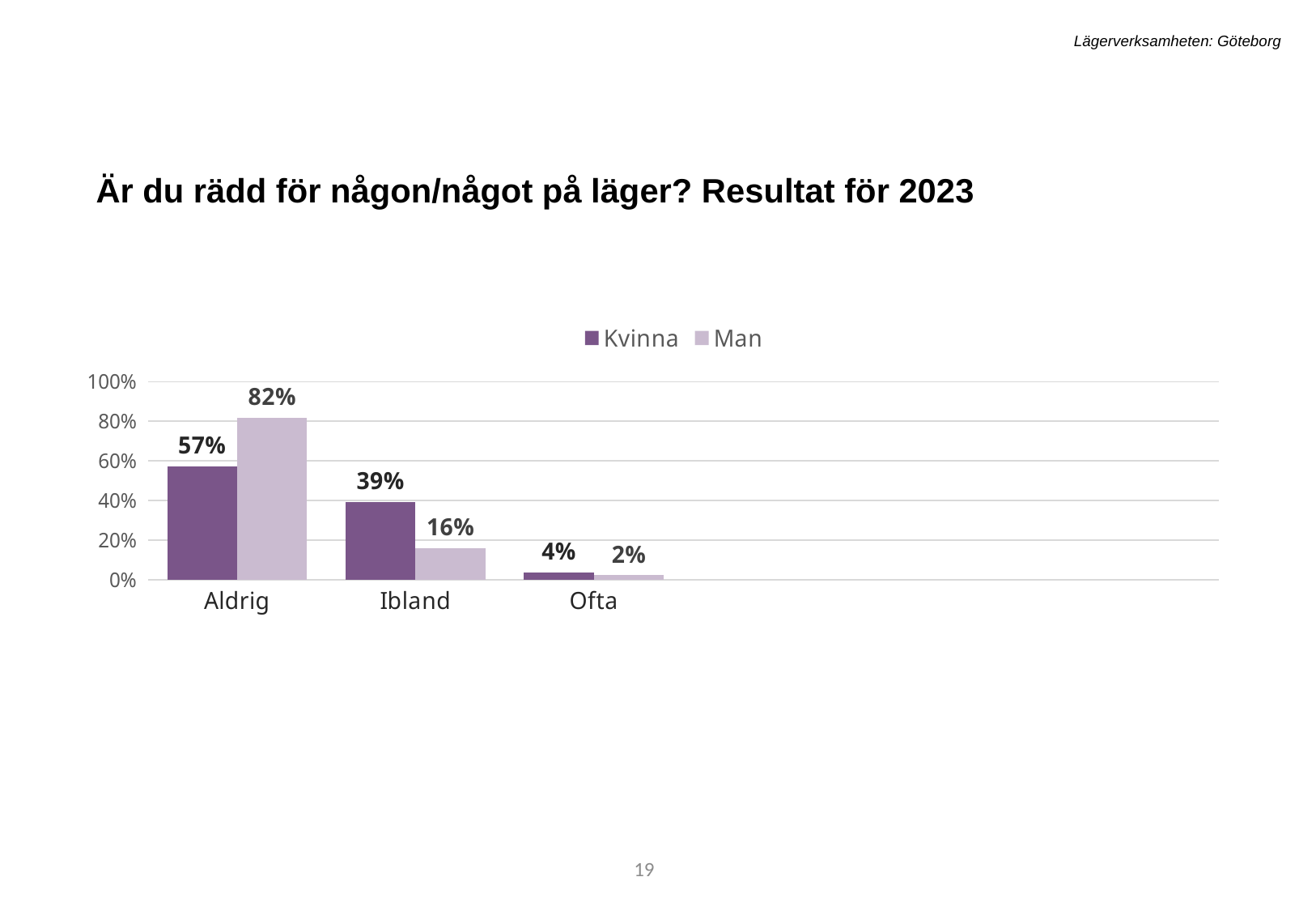
In the Ibland category, which series has the larger value, Kvinna or Man? Kvinna Which category has the lowest value for the Kvinna series? Ofta What is the difference between the Kvinna and Man values in the Ibland category? 23% What kind of chart is shown on the slide? Bar chart How many categories are shown on the x axis? 3 What is the value for Kvinna in the Aldrig category? 57% How many series does the legend list? 2 What is the value for Man in the Ofta category? 2% What is the value for Kvinna in the Ibland category? 39% Which category has the highest value for the Man series? Aldrig What is the difference between the Man and Kvinna values in the Aldrig category? 25% What is the value for Man in the Aldrig category? 82%